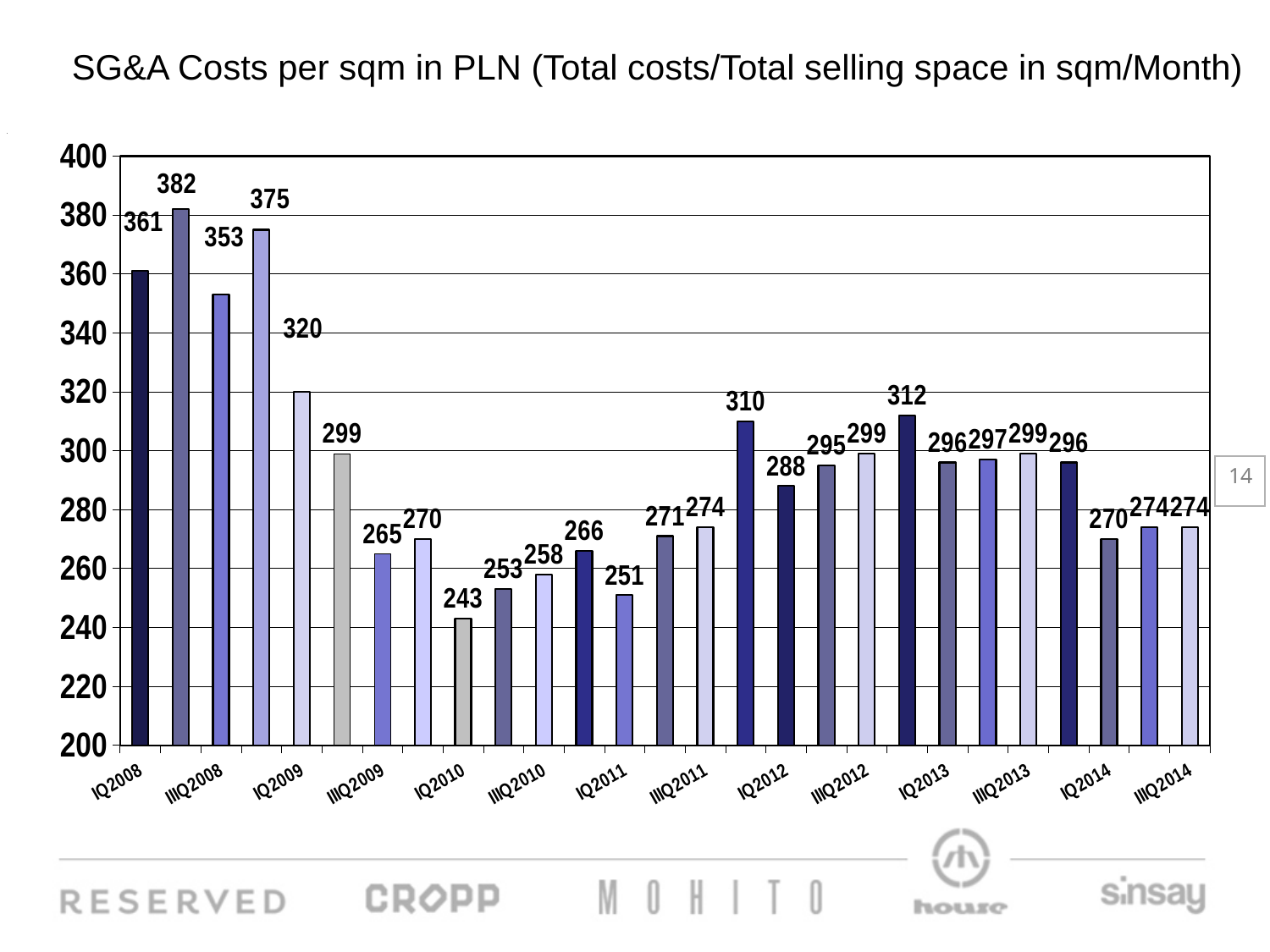
What is the title of the chart? SG&A Costs per sqm in PLN (Total costs/Total selling space in sqm/Month) Do the values rise or fall from IQ2008 to IQ2010? fall What is the highest value labelled on any bar in the chart? 382 Which labelled quarter has the lowest SG&A cost per sqm? IQ2010 What is the SG&A cost per sqm for IQ2010? 243 What is the value shown for IQ2013? 296 What type of chart is shown on the slide? bar chart What is the value shown for IIIQ2009? 265 How many quarter labels are shown on the x axis? 14 Which is larger, the value for IQ2012 or the value for IIIQ2012? IIIQ2012 What is the difference between the values for IQ2008 and IQ2014? 91 What is the value shown for IQ2008? 361